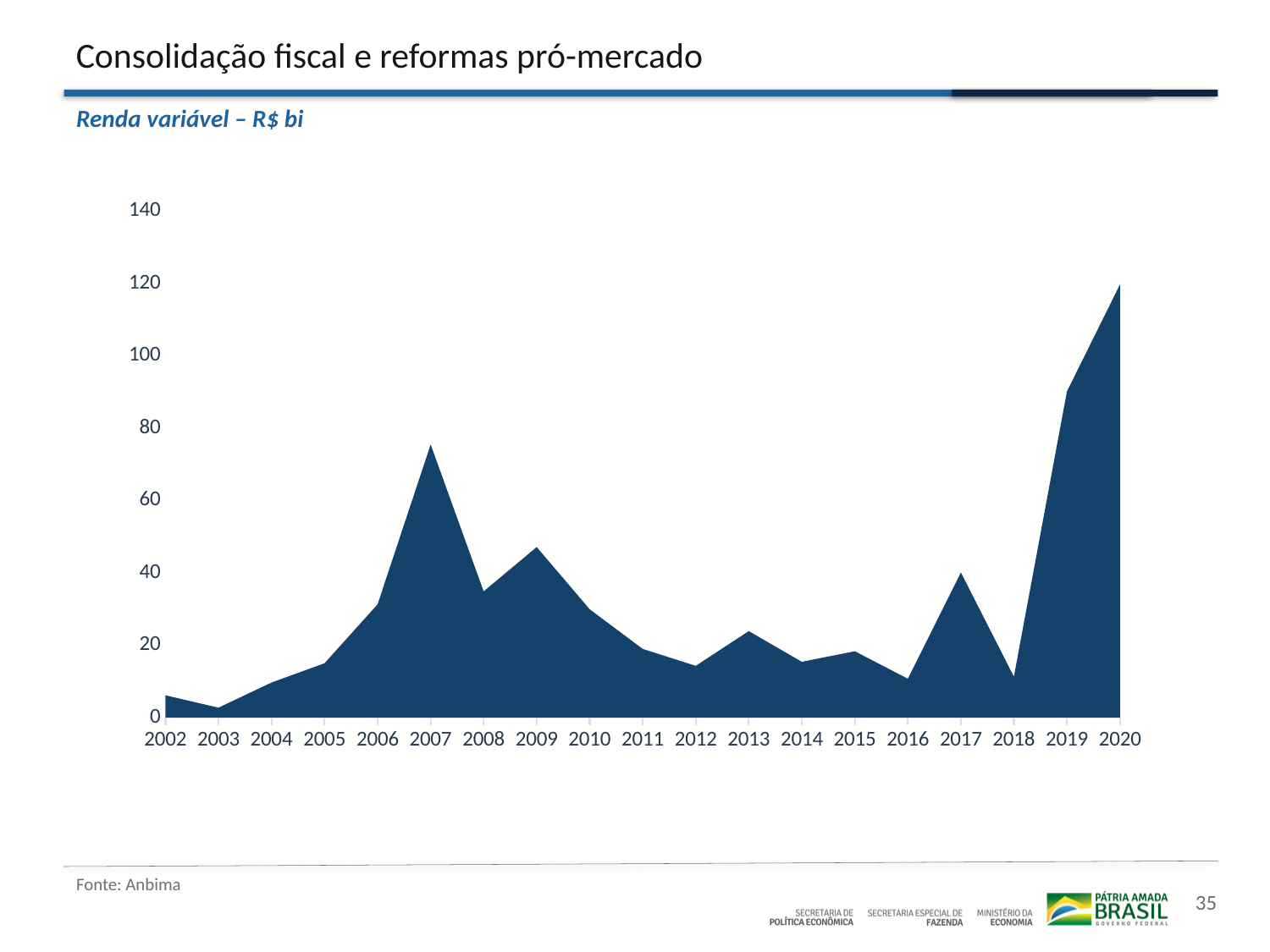
Which year has the lowest value in the chart? 2003 Do the values rise or fall from 2018 to 2020? rise Which year has the larger value, 2007 or 2009? 2007 Is the value for 2020 greater or less than 100? greater Is the value for 2007 greater or less than 60? greater What source is cited for the chart? Anbima How many years are shown on the x axis of the chart? 19 Is the value for 2012 greater or less than 20? less What is the title of the chart? Renda variável – R$ bi Which year has the highest value in the chart? 2020 What kind of chart is shown on the slide? Area chart